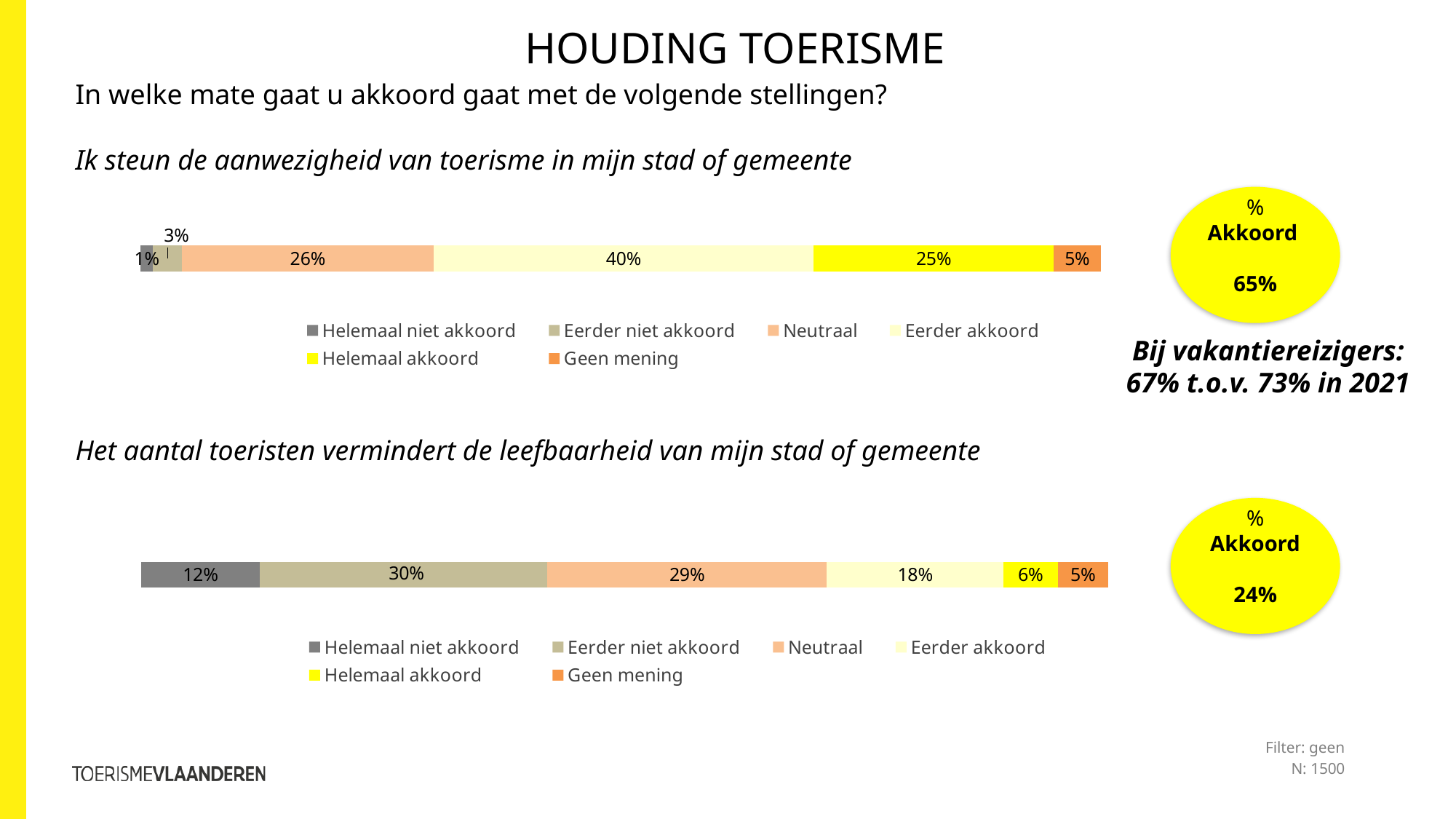
In the chart for 'Het aantal toeristen vermindert de leefbaarheid van mijn stad of gemeente', which category has the highest value? Eerder niet akkoord In the chart for 'Ik steun de aanwezigheid van toerisme in mijn stad of gemeente', what is the value for Neutraal? 26% In the chart for 'Ik steun de aanwezigheid van toerisme in mijn stad of gemeente', which category has the highest value? Eerder akkoord In the chart for 'Ik steun de aanwezigheid van toerisme in mijn stad of gemeente', which category has the lowest value? Helemaal niet akkoord In the chart for 'Ik steun de aanwezigheid van toerisme in mijn stad of gemeente', what is the value for Eerder akkoord? 40% How many series does the legend list for the chart 'Ik steun de aanwezigheid van toerisme in mijn stad of gemeente'? 6 In the chart for 'Ik steun de aanwezigheid van toerisme in mijn stad of gemeente', what is the difference between Eerder akkoord and Helemaal akkoord? 15% In the chart for 'Het aantal toeristen vermindert de leefbaarheid van mijn stad of gemeente', which is larger: Helemaal niet akkoord or Eerder akkoord? Eerder akkoord What kind of chart is used for 'Het aantal toeristen vermindert de leefbaarheid van mijn stad of gemeente'? Stacked bar chart In the chart for 'Het aantal toeristen vermindert de leefbaarheid van mijn stad of gemeente', what is the value for Eerder niet akkoord? 30% In the chart for 'Het aantal toeristen vermindert de leefbaarheid van mijn stad of gemeente', what is the value for Helemaal akkoord? 6% In the chart for 'Het aantal toeristen vermindert de leefbaarheid van mijn stad of gemeente', what is the difference between Eerder niet akkoord and Neutraal? 1%